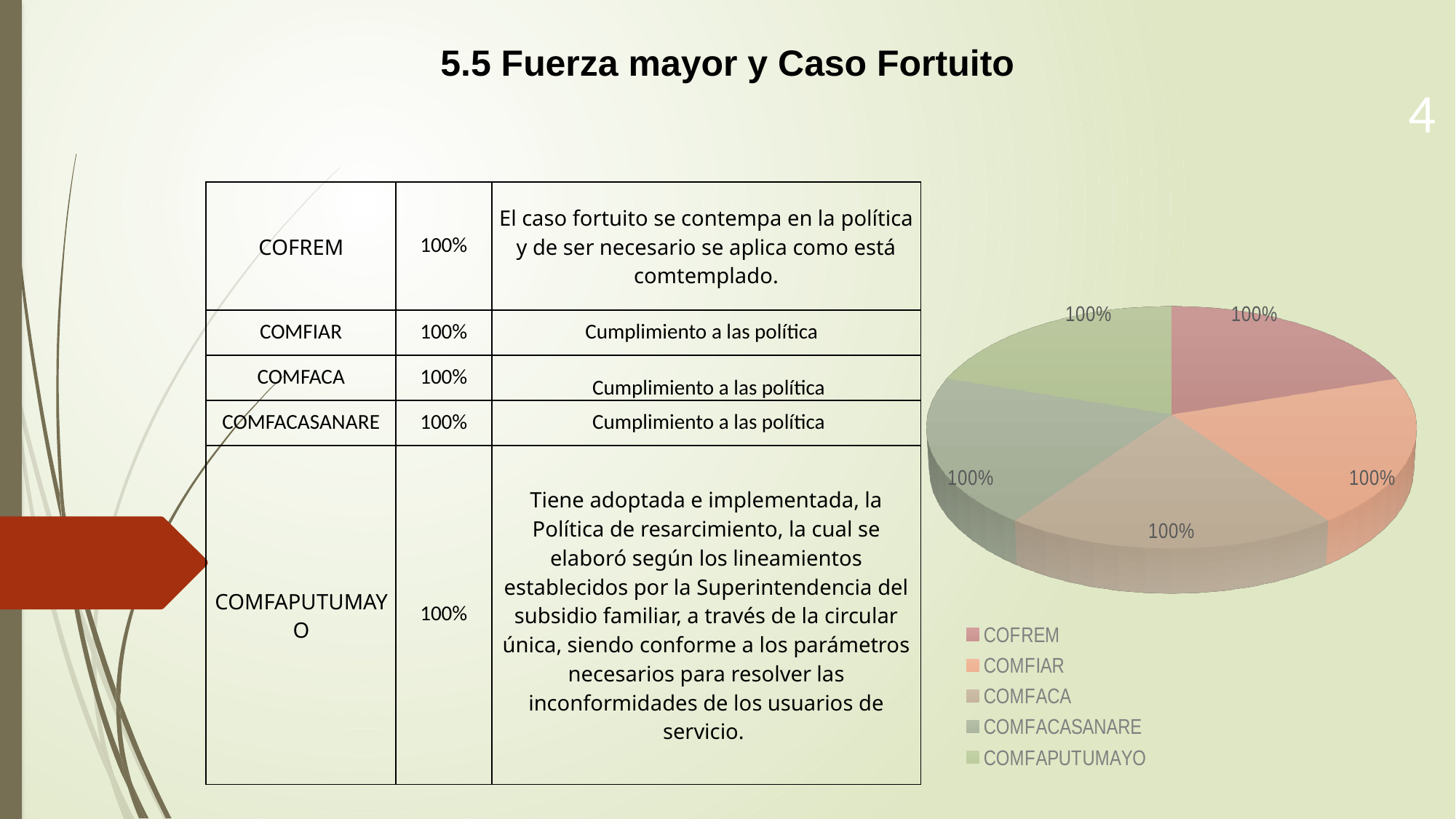
What value is shown for COMFACA in the pie chart? 100% What kind of chart is shown on the slide? pie chart What value is shown for COMFACASANARE in the pie chart? 100% How many slices does the pie chart have? 5 How many entries does the legend of the pie chart list? 5 Which entry is listed last in the legend of the pie chart? COMFAPUTUMAYO What value is shown for COMFAPUTUMAYO in the pie chart? 100% What is the difference between the values shown for COFREM and COMFIAR in the pie chart? 0% Which entry is listed first in the legend of the pie chart? COFREM What value is shown for COMFIAR in the pie chart? 100% What value is shown for COFREM in the pie chart? 100%